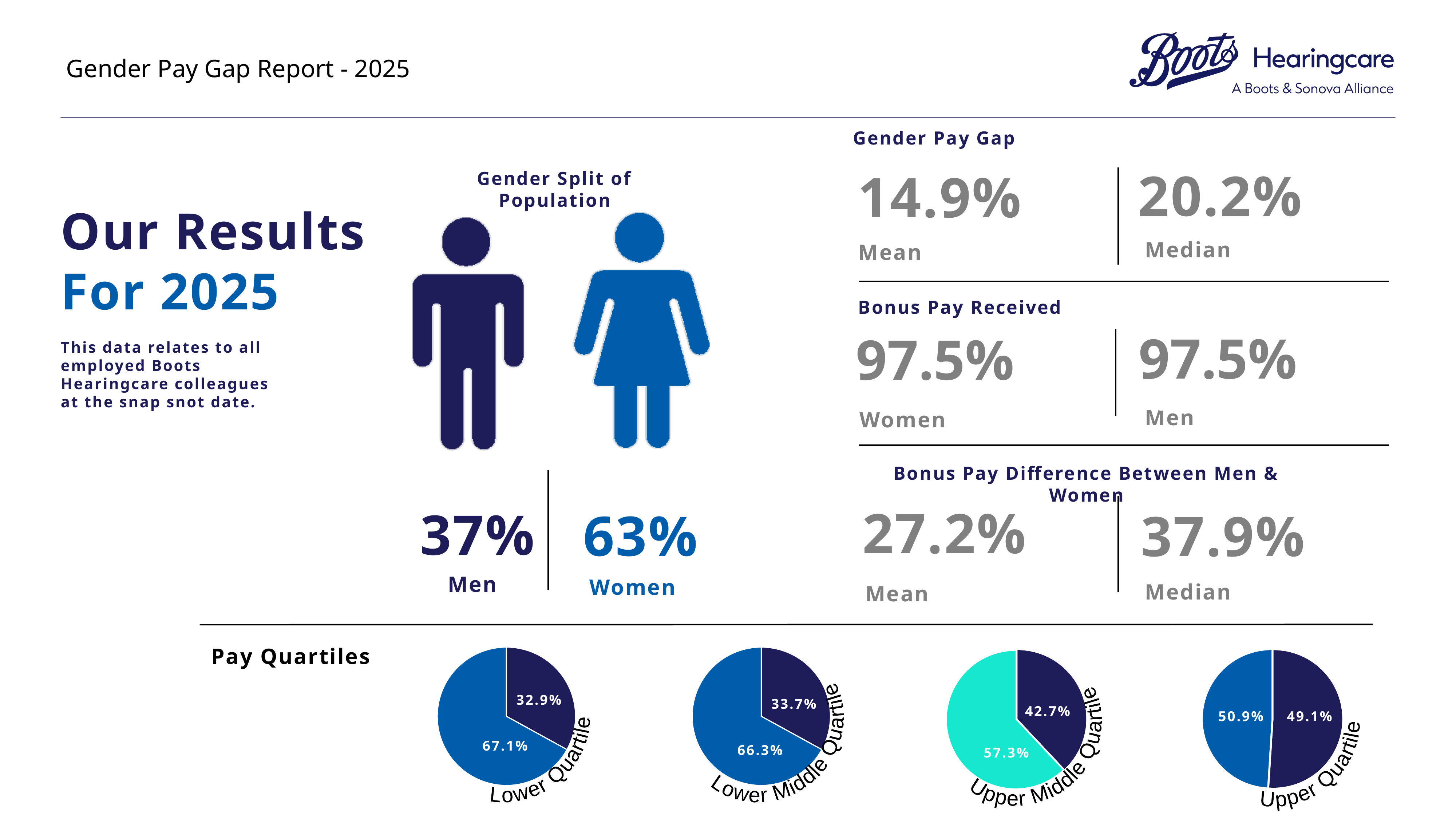
In the Upper Quartile pie chart, what is the value of the dark navy slice? 49.1% Is the dark navy slice larger in the Lower Middle Quartile pie chart or the Upper Middle Quartile pie chart? Upper Middle Quartile Which pie chart has the largest dark navy slice? Upper Quartile How many pie charts are shown in the Pay Quartiles section? 4 In the Upper Quartile pie chart, what is the difference between the two slices? 1.8% What kind of chart is used for the Pay Quartiles section? Pie chart In the Lower Quartile pie chart, what is the value of the dark navy slice? 32.9% In the Upper Middle Quartile pie chart, what is the value of the teal slice? 57.3% In the Lower Middle Quartile pie chart, what is the value of the dark navy slice? 33.7% Which pie chart has the smallest dark navy slice? Lower Quartile In the Upper Middle Quartile pie chart, what is the difference between the two slices? 14.6% In the Lower Quartile pie chart, what is the value of the larger slice? 67.1%